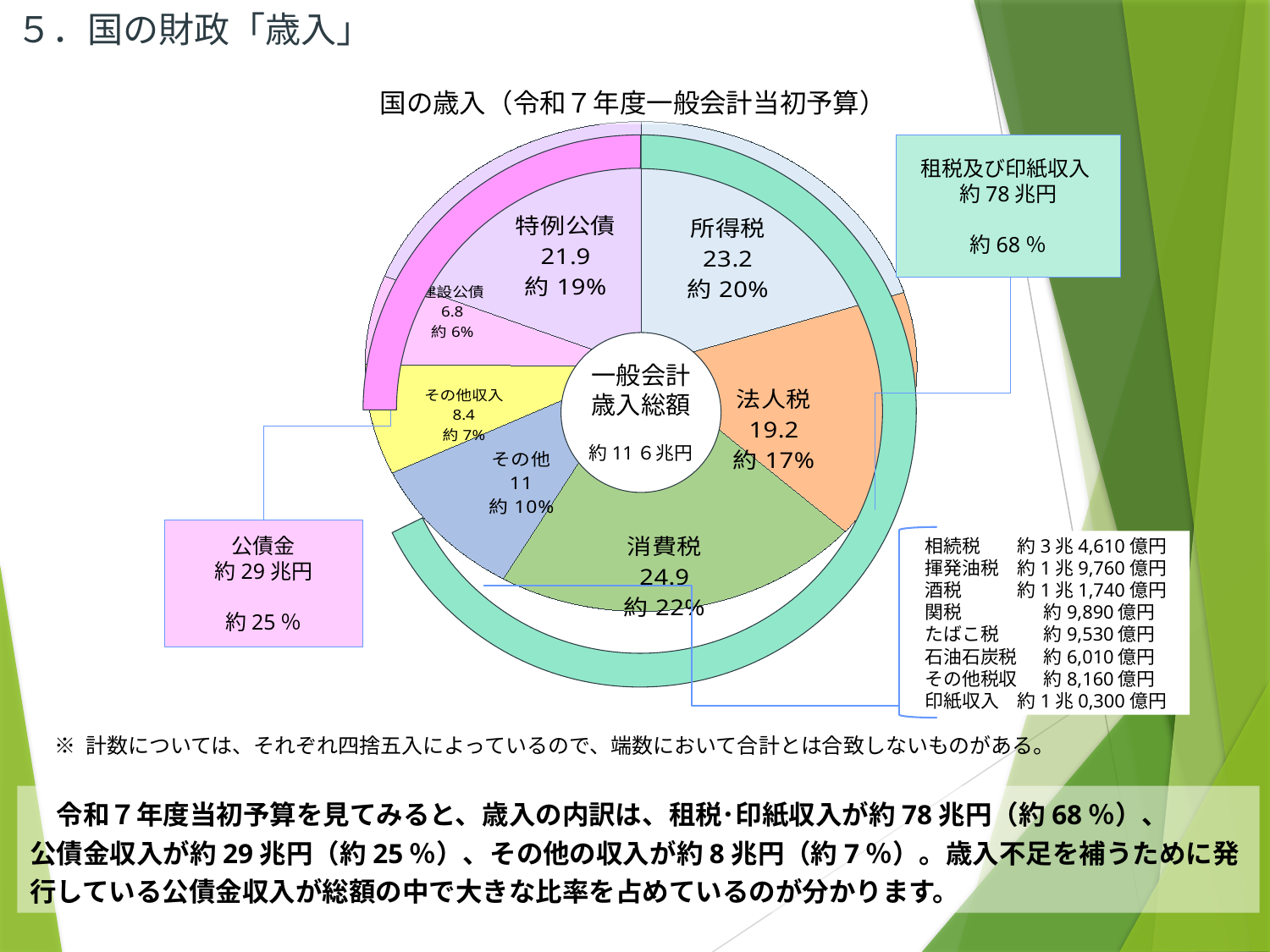
Which slice of the chart has the largest value? 消費税 What value is shown for 建設公債 in the chart? 6.8 What share of the pie does 法人税 represent, as printed on the slide? 約 17% What is the title of the chart? 国の歳入（令和７年度一般会計当初予算） What kind of chart is shown on the slide? pie chart Which slice of the chart has the smallest value? 建設公債 What value is shown for 所得税 in the chart? 23.2 What is the difference between the values for 消費税 and 所得税? 1.7 What value is shown for 消費税 in the chart? 24.9 Which is larger, the value for その他収入 or the value for その他? その他 How many slices does the pie chart have? 7 What value is shown for 特例公債 in the chart? 21.9